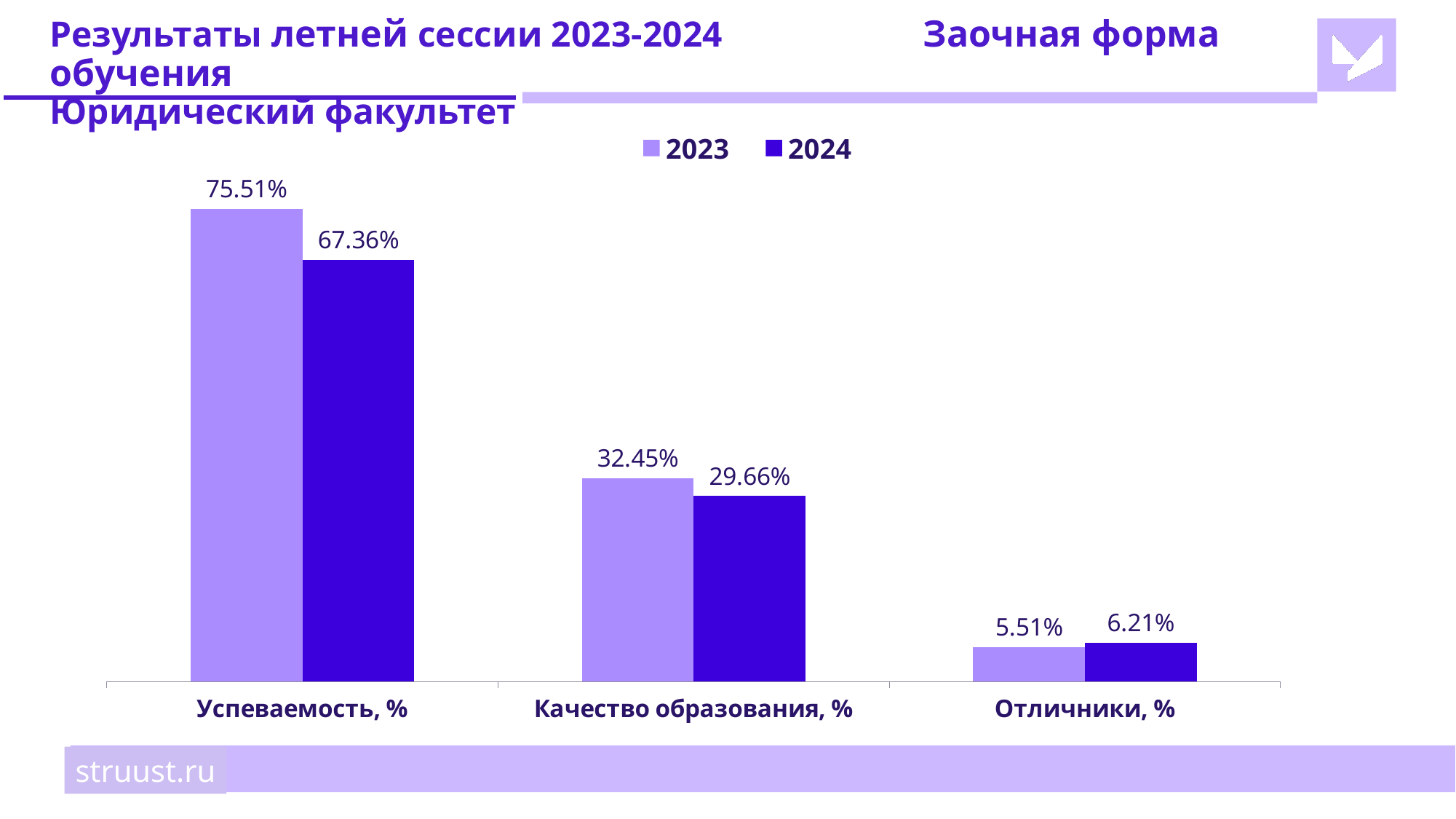
What is the difference between the 2023 and 2024 values for Успеваемость, %? 8.15% What is the difference between the 2023 and 2024 values for Качество образования, %? 2.79% What is the value for Успеваемость, % in 2023? 75.51% What is the value for Отличники, % in 2023? 5.51% What kind of chart is shown on the slide? Bar chart How many categories are shown on the x axis? 3 For Отличники, %, which year has the larger value, 2023 or 2024? 2024 Which category has the highest value for 2024? Успеваемость, % What is the value for Успеваемость, % in 2024? 67.36% What is the value for Качество образования, % in 2024? 29.66% How many series does the legend list? 2 Which category has the lowest value for 2023? Отличники, %